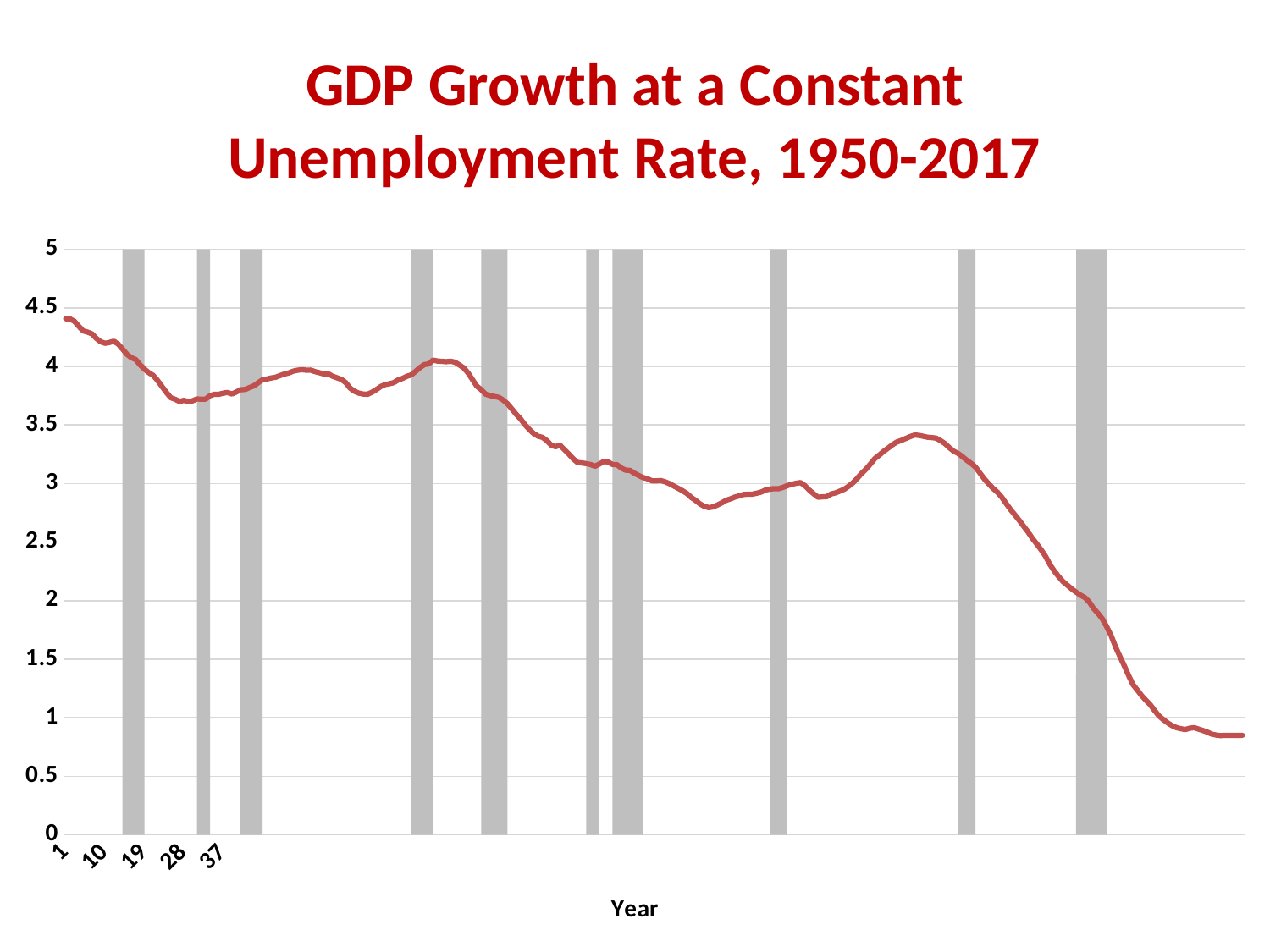
Is the value at x = 37 greater or less than 3.5? greater Is the line's lowest value at the start or at the end of the series? end Is the value at the first point (x = 1) greater or less than 4? greater Overall, does the line rise or fall from left to right along the x axis? fall Is the line's highest value at the start or at the end of the series? start What is the label on the x axis of the chart? Year Is the value at x = 10 greater or less than 4? greater What kind of chart is shown on the slide? line chart What is the highest value shown on the y axis? 5 What is the title of the chart? GDP Growth at a Constant Unemployment Rate, 1950-2017